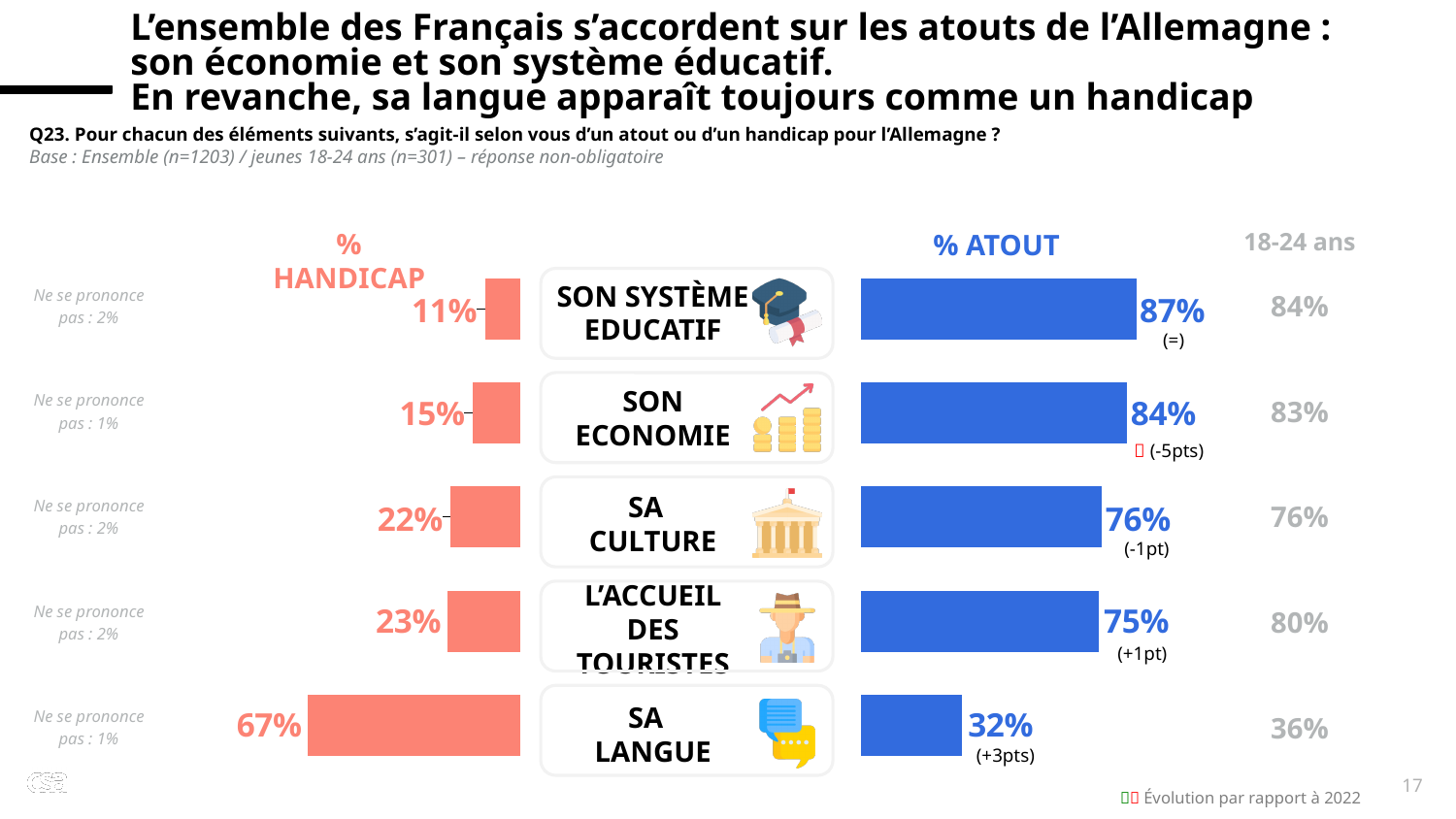
What is the 18-24 ans value for "L'accueil des touristes"? 80% What is the % HANDICAP value for "Sa langue"? 67% Which item has the highest % ATOUT value? Son système éducatif Which item has the lowest % HANDICAP value? Son système éducatif What is the change versus 2022 shown for the % ATOUT value of "Son économie"? -5pts What is the % ATOUT value for "Son système éducatif"? 87% What is the "Ne se prononce pas" value for "Son économie"? 1% What is the difference between the % ATOUT and % HANDICAP values for "Sa langue"? 35 points How many items are compared in the chart? 5 What kind of chart is shown on the slide? Bar chart Which is larger for "Sa culture": the % ATOUT value or the % HANDICAP value? % ATOUT What colour are the % ATOUT bars? Blue